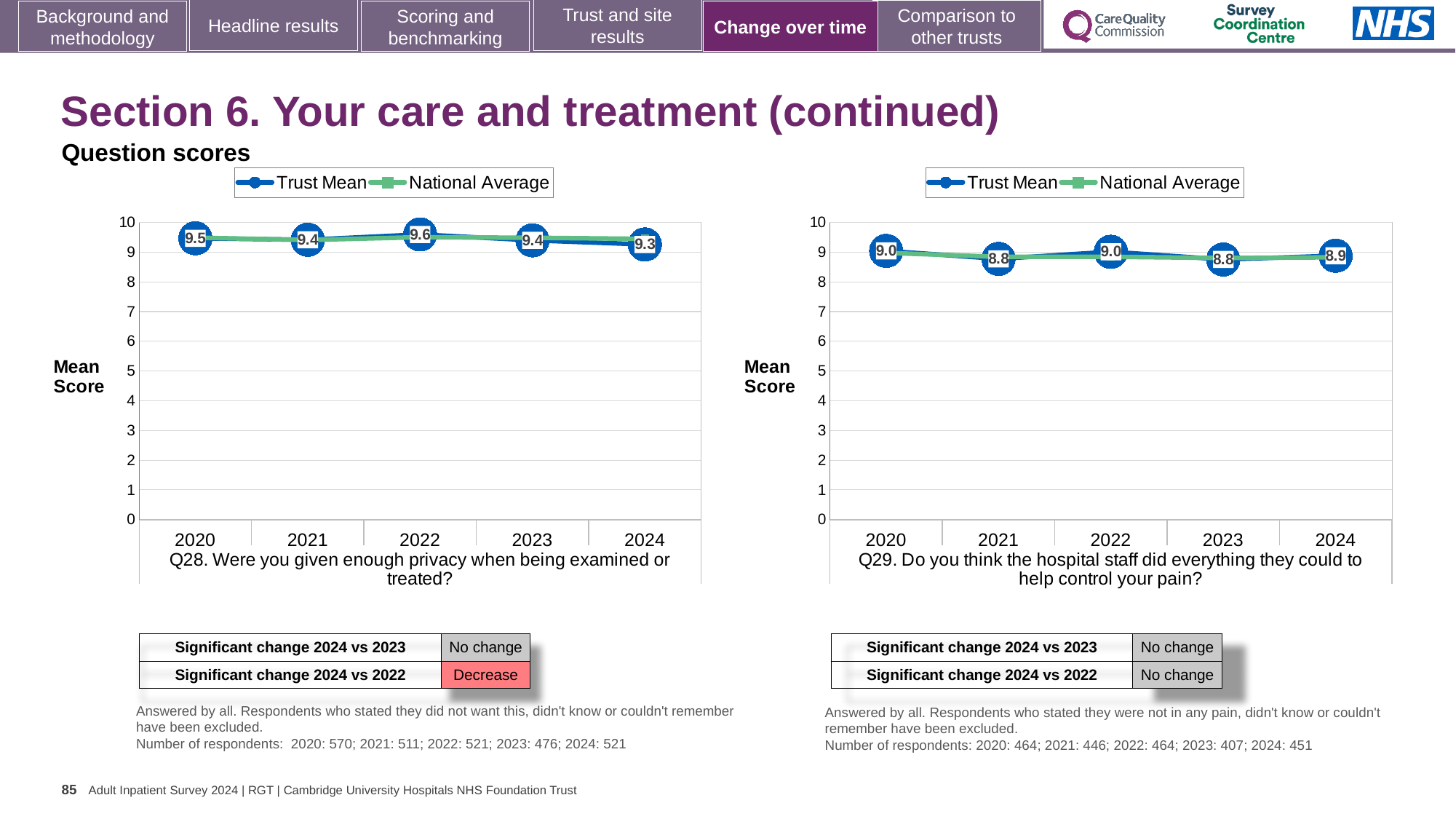
How many series does the legend of the Q29 chart (right) list? 2 In the Q29 chart (right), what is the Trust Mean score for 2024? 8.9 How many years are plotted on the x axis of the Q28 chart (left)? 5 In the Q29 chart (right), is the Trust Mean score for 2020 larger or smaller than the score for 2021? larger In the Q28 chart (left), what is the Trust Mean score for 2022? 9.6 What type of chart is used for the Q28 chart (left)? Line chart In the Q29 chart (right), what is the Trust Mean score for 2021? 8.8 In the Q28 chart (left), which year has the highest Trust Mean score? 2022 In the Q29 chart (right), is the National Average for 2023 greater or less than 5? greater In the Q28 chart (left), what is the Trust Mean score for 2024? 9.3 In the Q28 chart (left), which year has the lowest Trust Mean score? 2024 In the Q28 chart (left), what is the difference between the Trust Mean scores for 2020 and 2024? 0.2